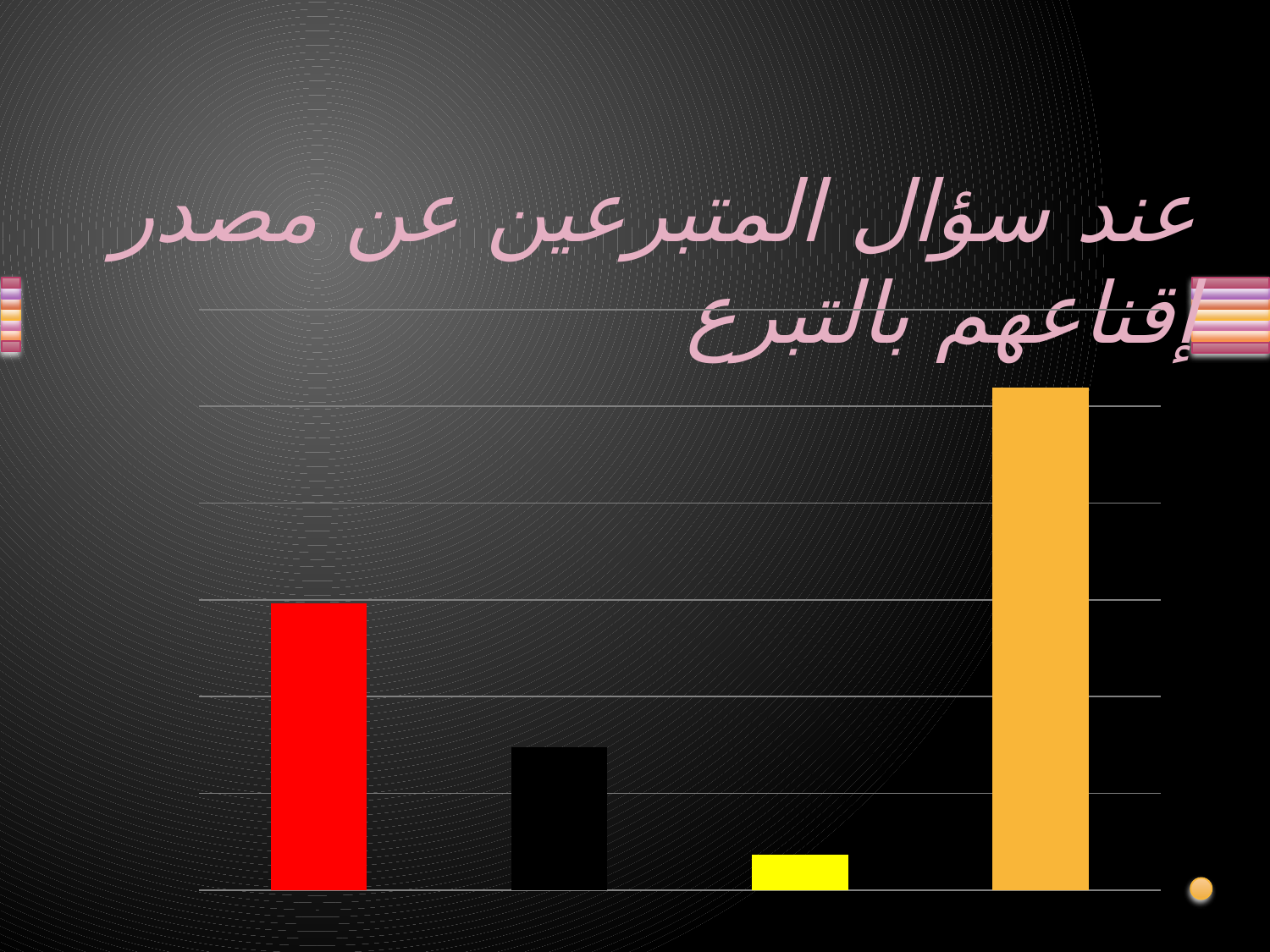
Which bar in the chart is the tallest? the orange bar What is the title of the slide containing the chart? عند سؤال المتبرعين عن مصدر إقناعهم بالتبرع Which is taller in the chart, the black bar or the yellow bar? the black bar Does the chart display a legend? No Which is taller in the chart, the orange bar or the red bar? the orange bar What kind of chart is shown on the slide? bar chart How many bars are plotted in the chart? 4 Which is taller in the chart, the red bar or the black bar? the red bar Which bar in the chart is the shortest? the yellow bar